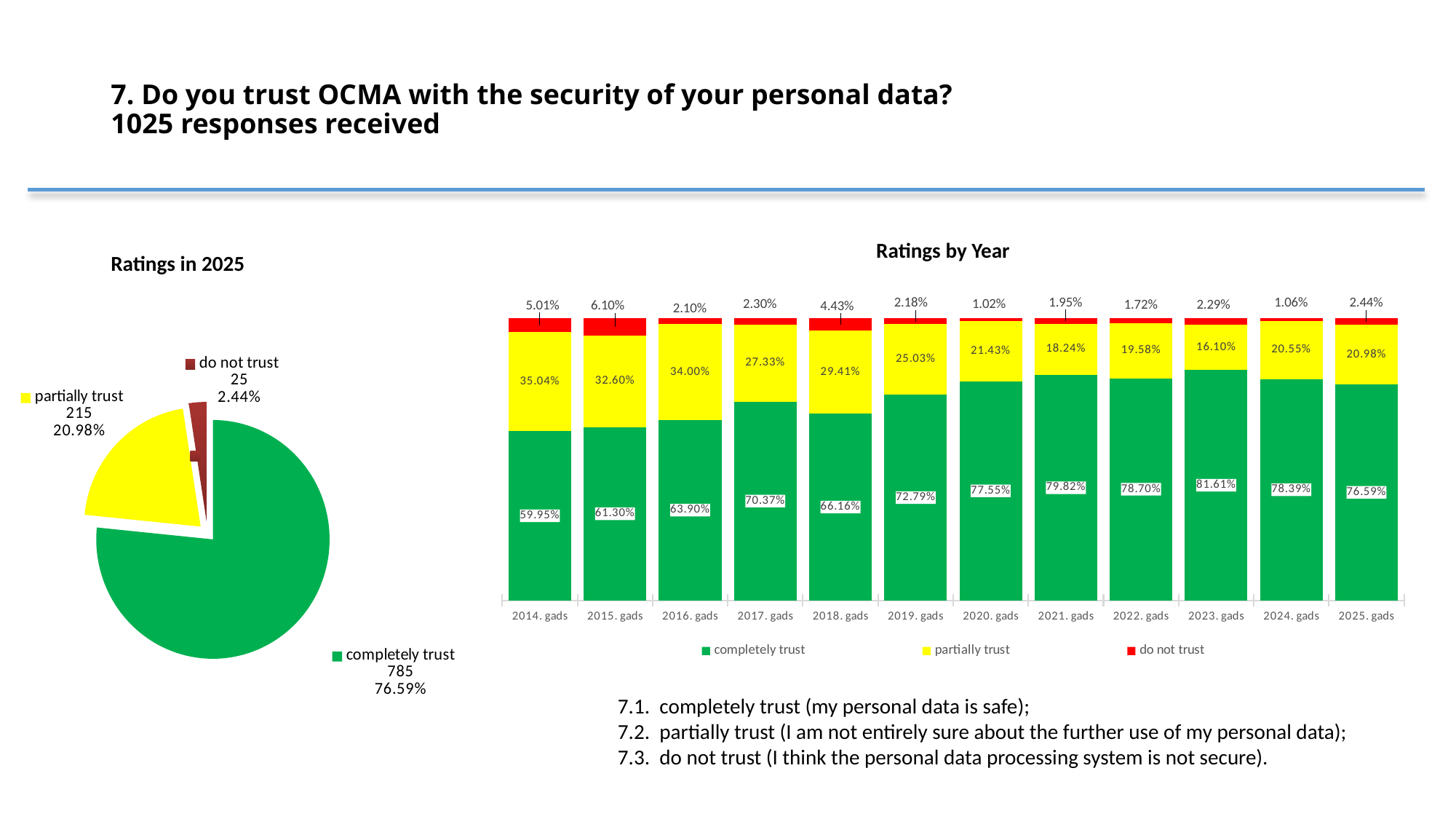
In the 'Ratings by Year' chart, what is the 'do not trust' value for 2015? 6.10% In the 'Ratings by Year' chart, how many years are shown on the x axis? 12 In the 'Ratings in 2025' pie chart, how many responses were 'completely trust'? 785 In the 'Ratings in 2025' pie chart, which category has the smallest slice? do not trust In the 'Ratings by Year' chart, which year has the lowest 'partially trust' value? 2023 In the 'Ratings by Year' chart, which year has the highest 'completely trust' value? 2023 In the 'Ratings by Year' chart, what is the 'completely trust' value for 2021? 79.82% In the 'Ratings in 2025' pie chart, what is the difference in number of responses between 'completely trust' and 'partially trust'? 570 In the 'Ratings by Year' chart, is the 'completely trust' value for 2014 larger or smaller than for 2025? smaller What kind of chart is 'Ratings in 2025'? pie chart In the 'Ratings by Year' chart, how many series does the legend list? 3 In the 'Ratings in 2025' pie chart, what share of responses is 'partially trust'? 20.98%